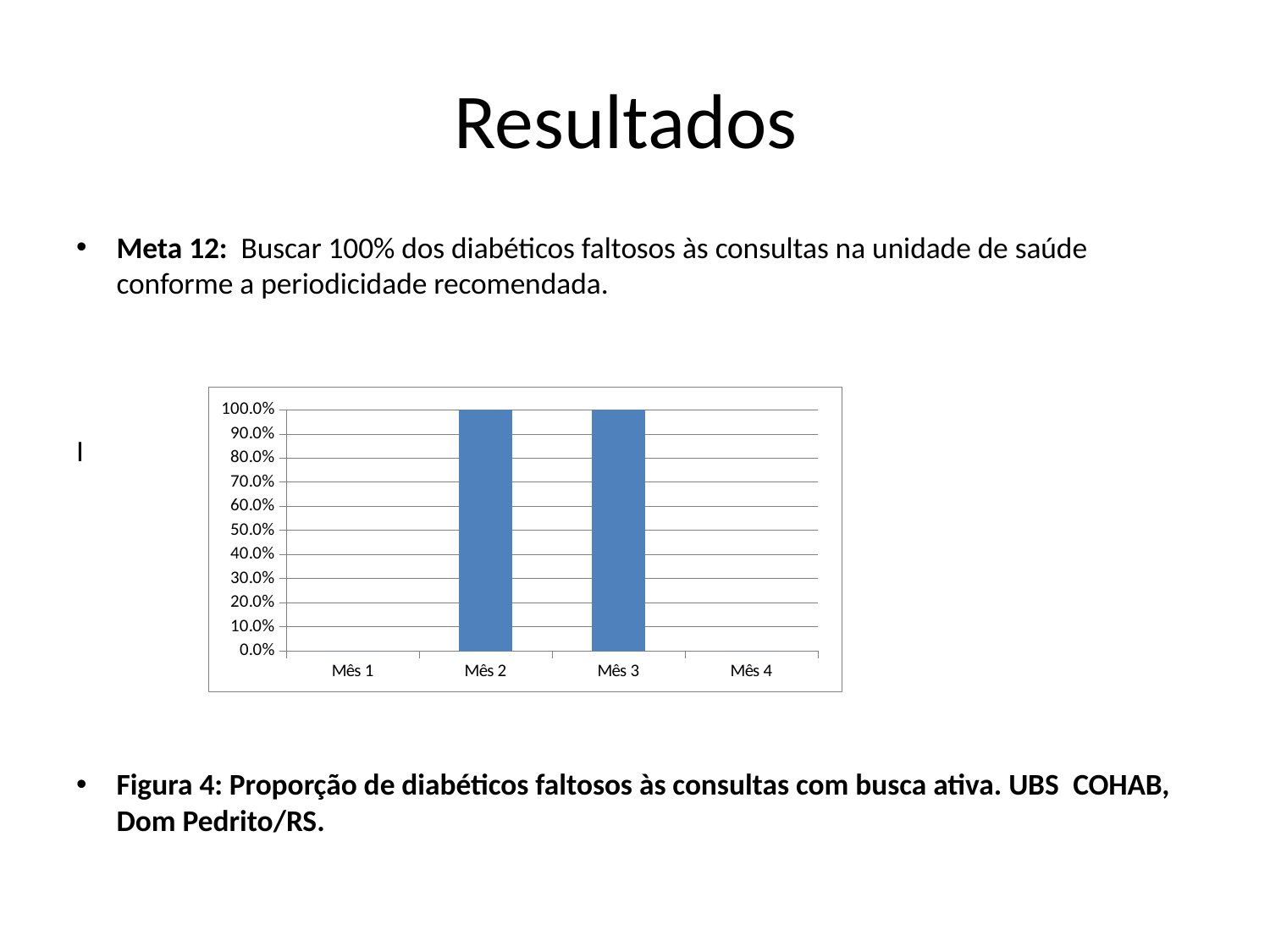
Is the value for Mês 3 greater or less than 90.0%? greater Is the value for Mês 2 greater or less than 50.0%? greater What is the figure number given in the caption below the chart? Figura 4 What is the value for Mês 2 in the chart? 100.0% Which is larger, the value for Mês 3 or the value for Mês 4? Mês 3 Do the values rise or fall from Mês 1 to Mês 2? rise Which is larger, the value for Mês 1 or the value for Mês 2? Mês 2 What is the value for Mês 3 in the chart? 100.0% What type of chart is shown on the slide? bar chart How many categories are shown on the x axis of the chart? 4 What is the difference between the values for Mês 2 and Mês 3? 0.0% What is the highest value shown on the y axis of the chart? 100.0%